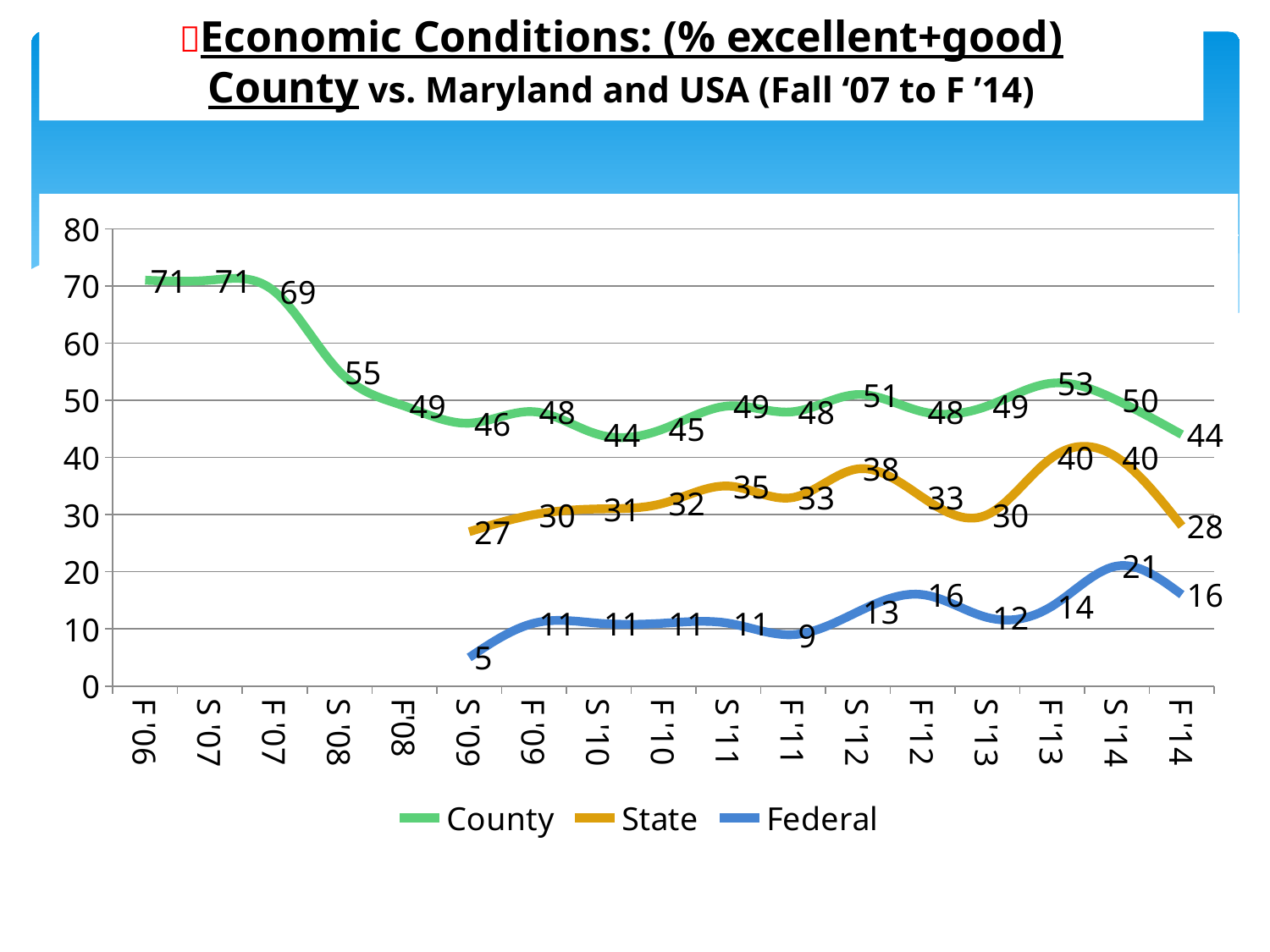
What kind of chart is shown on the slide? Line chart What is the County value at F'06? 71 What is the Federal value at S'14? 21 What is the difference between the County value at F'06 and at F'14? 27 What is the State value at S'12? 38 At S'12, which is larger, the County value or the State value? County How many series does the legend list? 3 At which period is the Federal series lowest? S'09 Does the County series rise or fall from F'06 to S'08? Fall At which period is the State series lowest? S'09 How many periods are shown on the x axis? 17 At which period is the Federal series highest? S'14